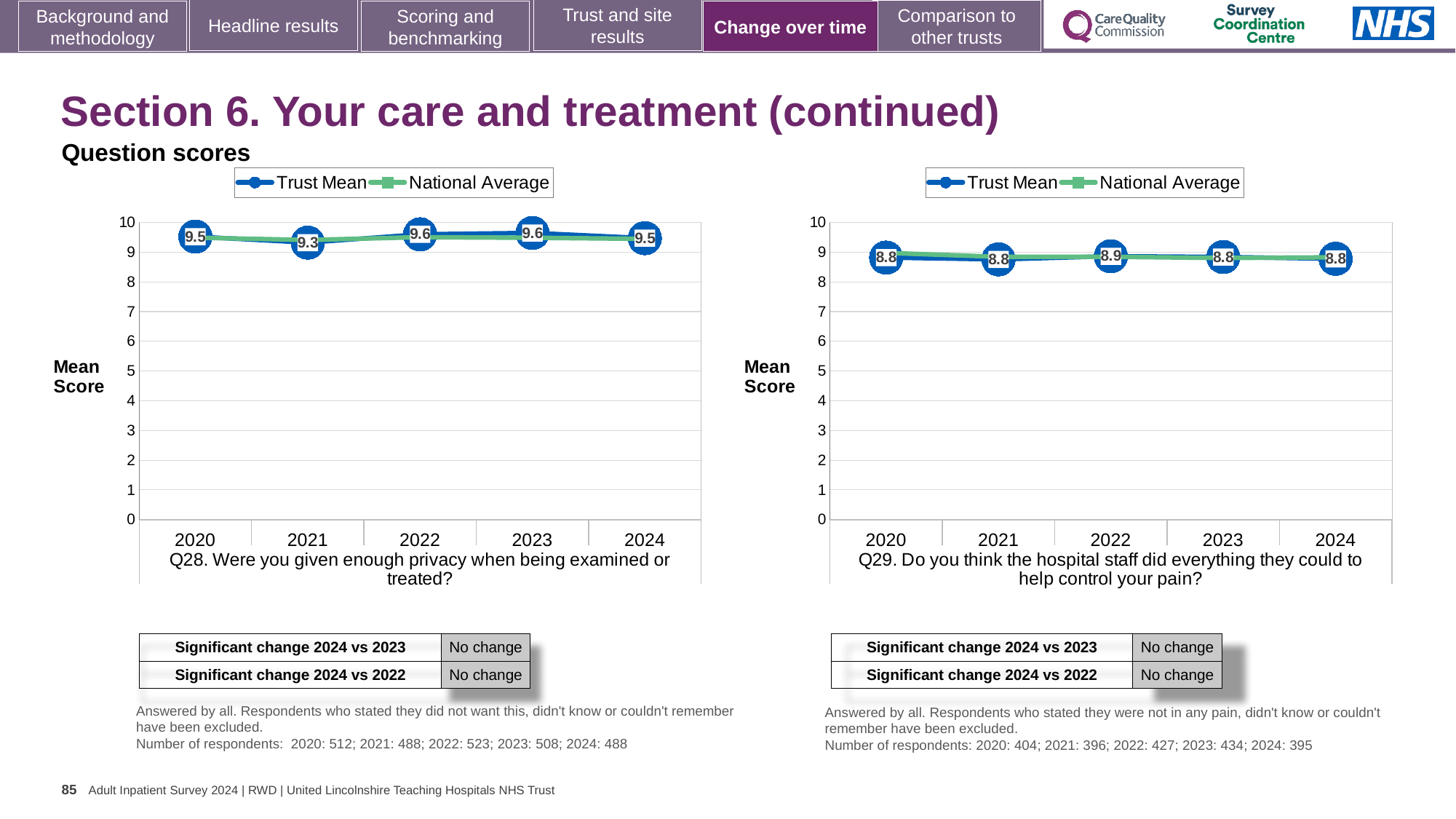
What are the two series named in the legend of the Q28 chart on the left? Trust Mean and National Average In the Q29 chart on the right, which year has the highest Trust Mean score? 2022 In the Q28 chart on the left, is the Trust Mean score higher in 2021 or in 2023? 2023 In the Q28 chart on the left, what is the Trust Mean score for 2021? 9.3 How many years are plotted on the x axis of the Q28 chart on the left? 5 How many series does the legend of the Q29 chart on the right list? 2 In the Q28 chart on the left, which year has the lowest Trust Mean score? 2021 In the Q28 chart on the left, what is the difference between the Trust Mean scores for 2022 and 2021? 0.3 What type of chart is used for Q28 on the left? Line chart In the Q28 chart on the left, does the Trust Mean score rise or fall from 2021 to 2022? Rise In the Q29 chart on the right, is the National Average value for 2024 greater or less than 8? greater In the Q29 chart on the right, what is the Trust Mean score for 2022? 8.9